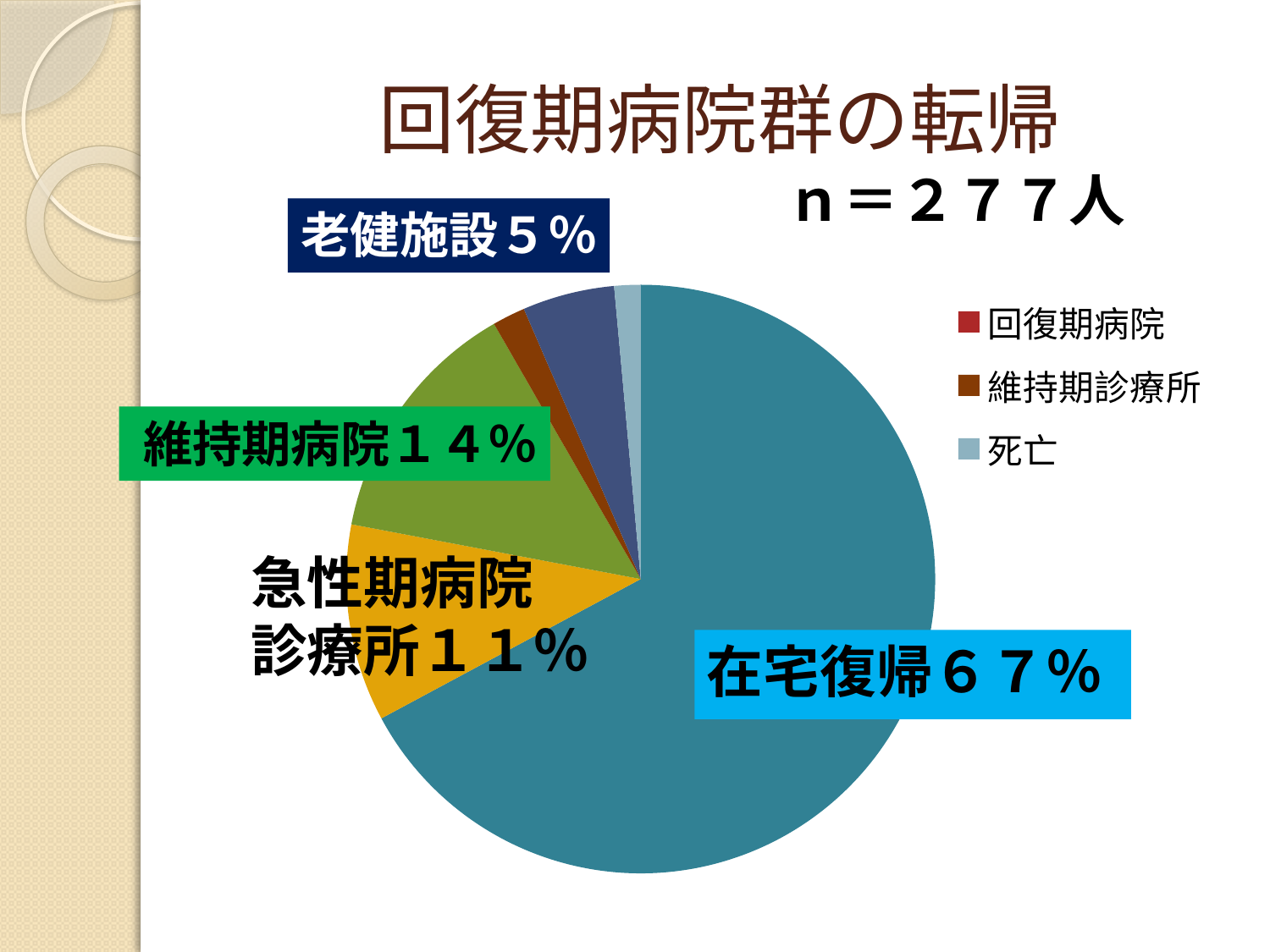
What is the difference in percentage points between 維持期病院 and 老健施設? 9 Which category has the largest slice of the pie chart? 在宅復帰 What share of the pie chart is labelled 在宅復帰? ６７％ What is the difference in percentage points between 在宅復帰 and 維持期病院? 53 What kind of chart is shown on the slide? Pie chart What percentage is shown for 急性期病院診療所 in the pie chart? １１％ Which is larger in the pie chart, 老健施設 or 急性期病院診療所? 急性期病院診療所 Which is larger in the pie chart, 維持期病院 or 急性期病院診療所? 維持期病院 What percentage is shown for 老健施設 in the pie chart? ５％ What sample size (n) is stated on the slide? ｎ＝２７７人 What percentage is shown for 維持期病院 in the pie chart? １４％ What is the title of the chart on the slide? 回復期病院群の転帰